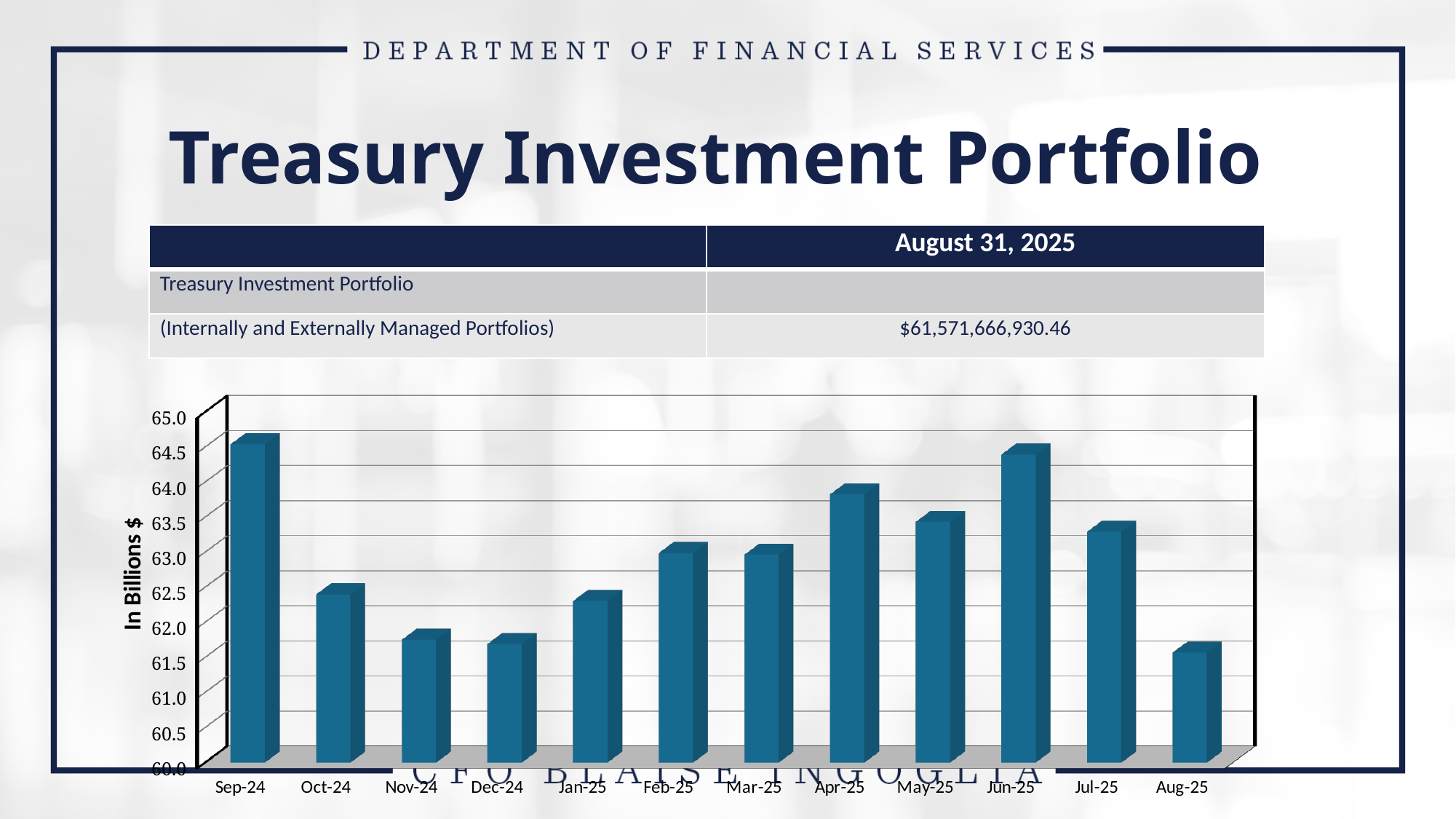
Which is larger, the value for Sep-24 or the value for Oct-24? Sep-24 Is the value for Apr-25 greater or less than 63.5? greater Is the value for Aug-25 greater or less than 62.0? less Is the value for Jun-25 greater or less than 64.0? greater Which is larger, the value for Apr-25 or the value for May-25? Apr-25 Do the values rise or fall from Dec-24 to Feb-25? rise How many months are plotted on the chart? 12 What is the label on the vertical axis of the chart? In Billions $ What kind of chart is shown on the slide? bar chart Which is larger, the value for Jun-25 or the value for Jul-25? Jun-25